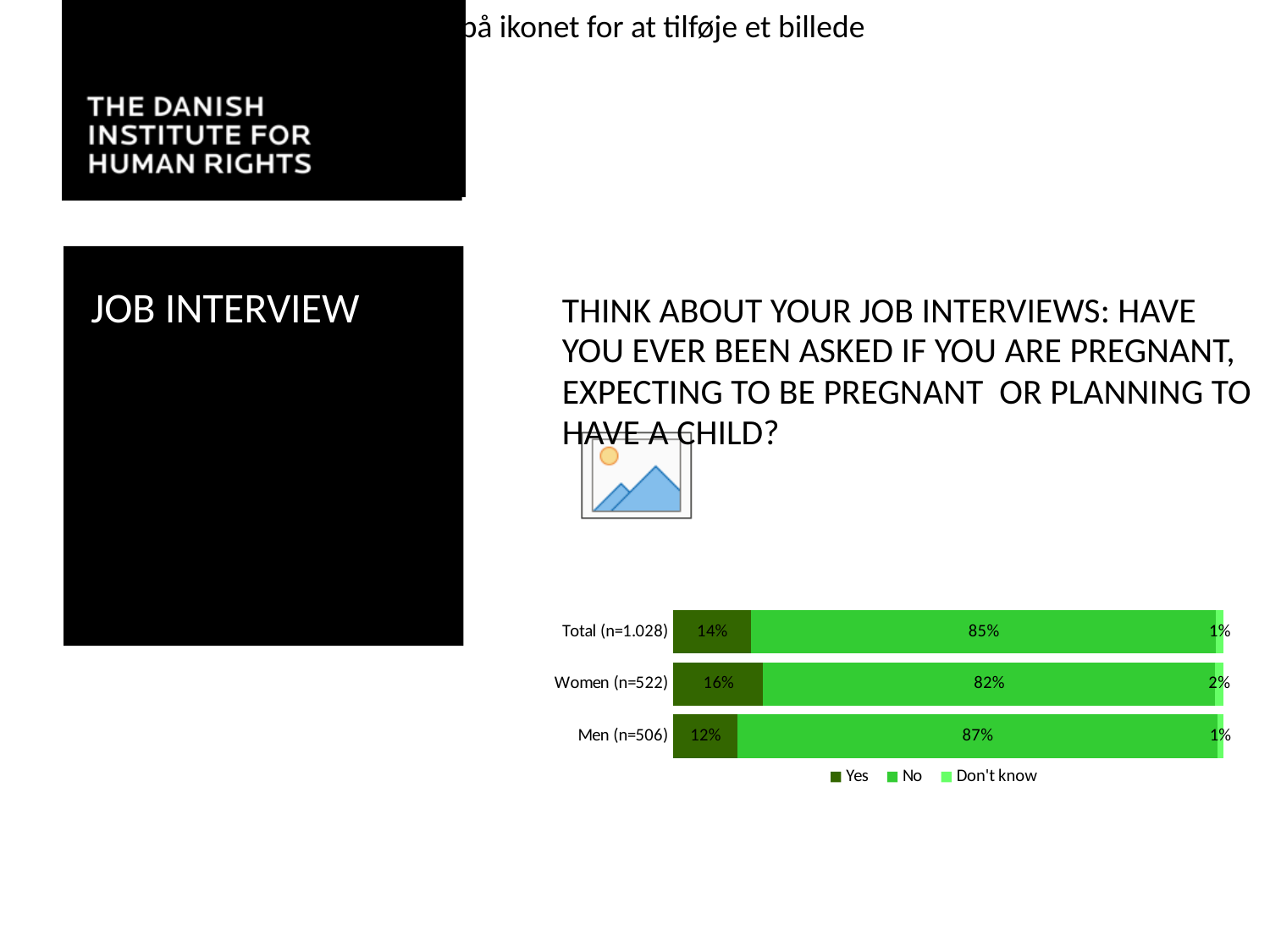
How many groups (bars) are shown in the chart? 3 Which group has the lowest "No" percentage? Women (n=522) What kind of chart is shown on the slide? Stacked bar chart What percentage of women (n=522) answered "Yes"? 16% What are the three legend entries of the chart? Yes, No, Don't know What percentage of men (n=506) answered "No"? 87% What is the "Don't know" value for Total (n=1.028)? 1% Which group has the highest "Yes" percentage? Women (n=522) What is the difference between the "Yes" percentages for women and men? 4% What is the "Yes" value for Total (n=1.028)? 14% Is the "No" percentage larger for men or for women? Men How many series does the legend list? 3